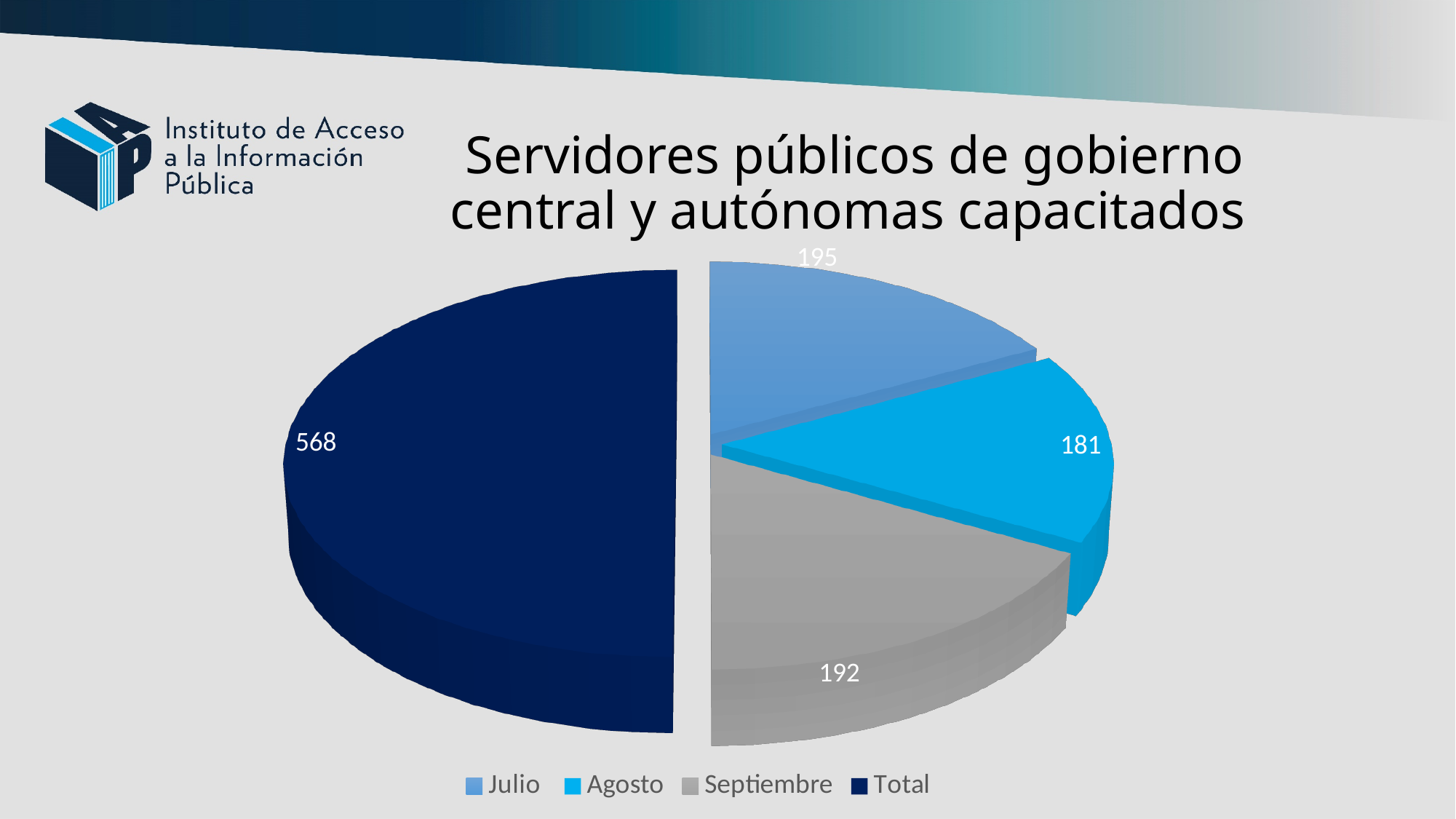
What is the value for Septiembre? 192 What is the value for the Total slice? 568 What type of chart is shown on the slide? pie chart Which slice has the smallest value? Agosto What is the value for Agosto? 181 What is the difference between the values for Julio and Agosto? 14 How many slices does the pie chart have? 4 What is the difference between the values for Septiembre and Agosto? 11 Which slice has the largest value? Total Which is larger, the value for Julio or the value for Septiembre? Julio What is the value for Julio? 195 What is the title of the chart? Servidores públicos de gobierno central y autónomas capacitados